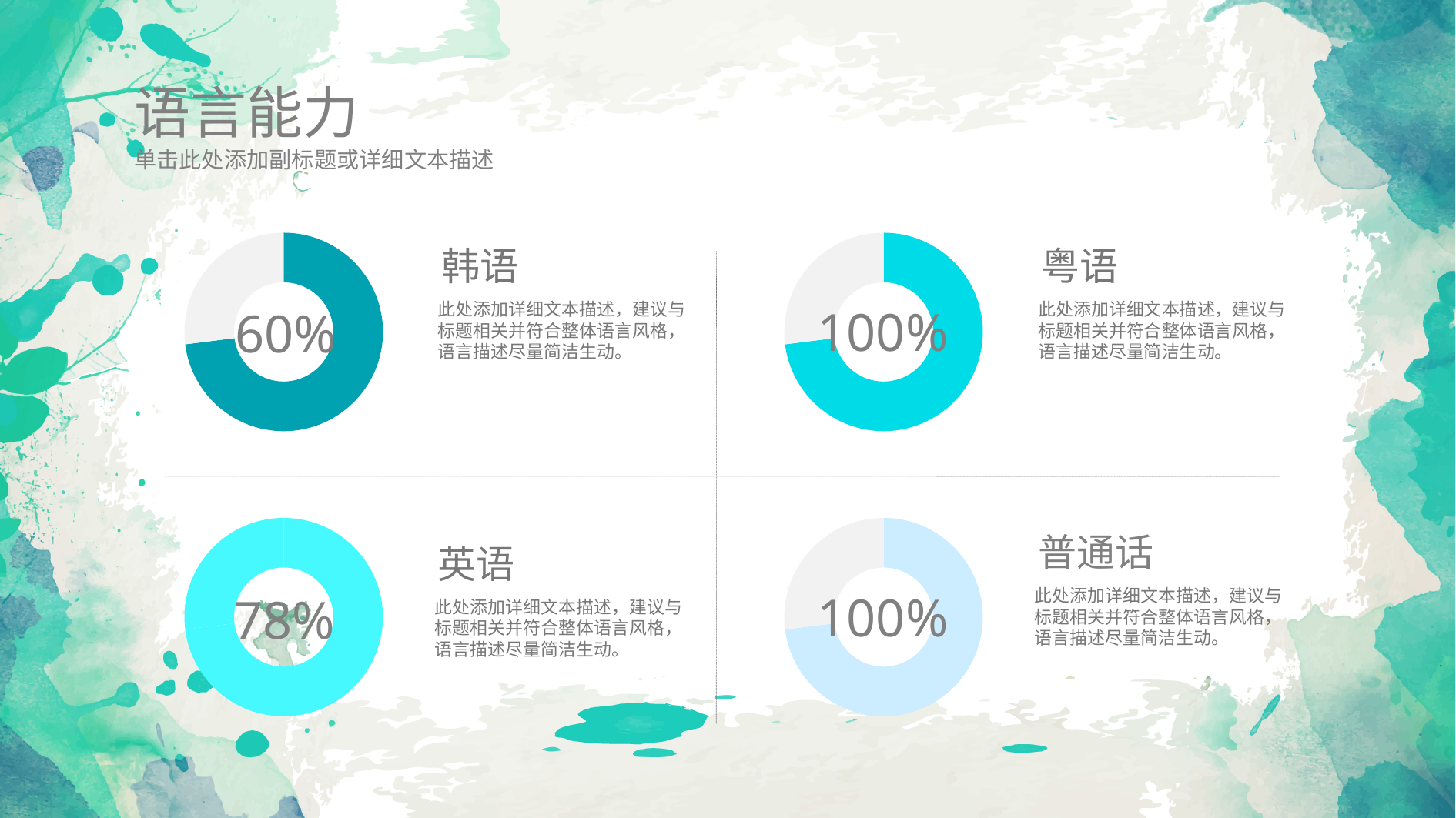
What value is shown in the 普通话 donut chart? 100% What value is shown in the 英语 donut chart? 78% Which language's donut chart is drawn in light blue? 普通话 What is the title of the slide containing the charts? 语言能力 Which language has the lowest value shown on the slide? 韩语 What kind of chart is used for each language on the slide? Donut chart What is the difference between the 英语 value and the 韩语 value? 18% How many donut charts are on the slide? 4 Which is larger, the value for 韩语 or the value for 英语? 英语 What is the difference between the 粤语 value and the 英语 value? 22% What value is shown in the 粤语 donut chart? 100% What value is shown in the 韩语 donut chart? 60%